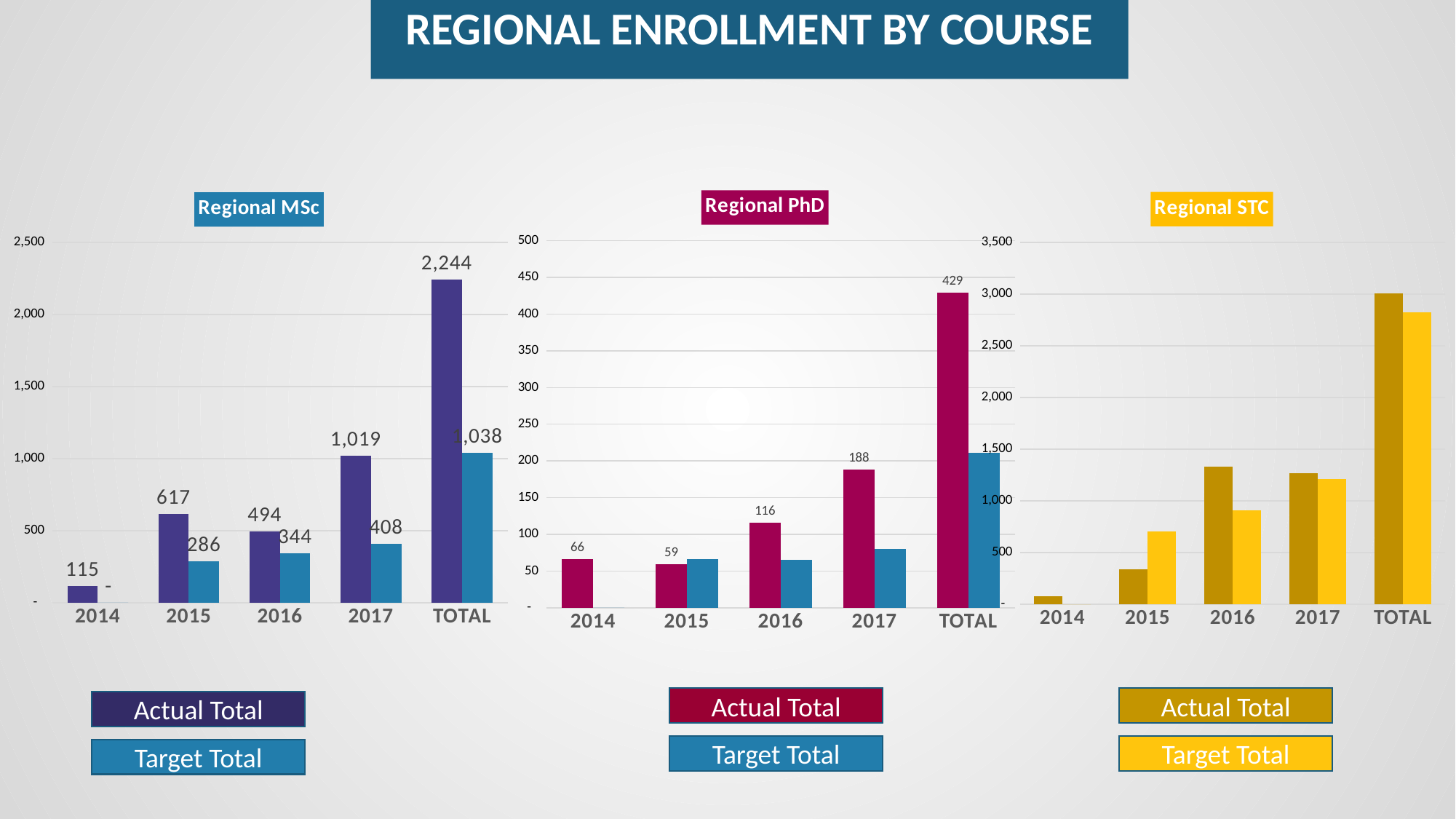
In the Regional PhD chart, by how much did the Actual Total increase from 2016 to 2017? 72 In the Regional PhD chart, what is the Actual Total for 2016? 116 In the Regional PhD chart, which of the years 2014 to 2017 has the lowest Actual Total? 2015 In the Regional STC chart, is the Actual Total for the TOTAL category greater or less than 2,500? greater In the Regional PhD chart, which of the years 2014 to 2017 has the highest Actual Total? 2017 In the Regional MSc chart, what is the Target Total for 2016? 344 In the Regional MSc chart, how much larger is the Actual Total than the Target Total in 2015? 331 In the Regional STC chart, is the Target Total for 2015 greater or less than 500? greater How many series does the legend of the Regional PhD chart list? 2 In the Regional MSc chart, what is the difference between the Actual Total and the Target Total for the TOTAL category? 1,206 In the Regional STC chart, which is larger for 2016: the Actual Total or the Target Total? Actual Total In the Regional MSc chart, what is the Actual Total for 2017? 1,019